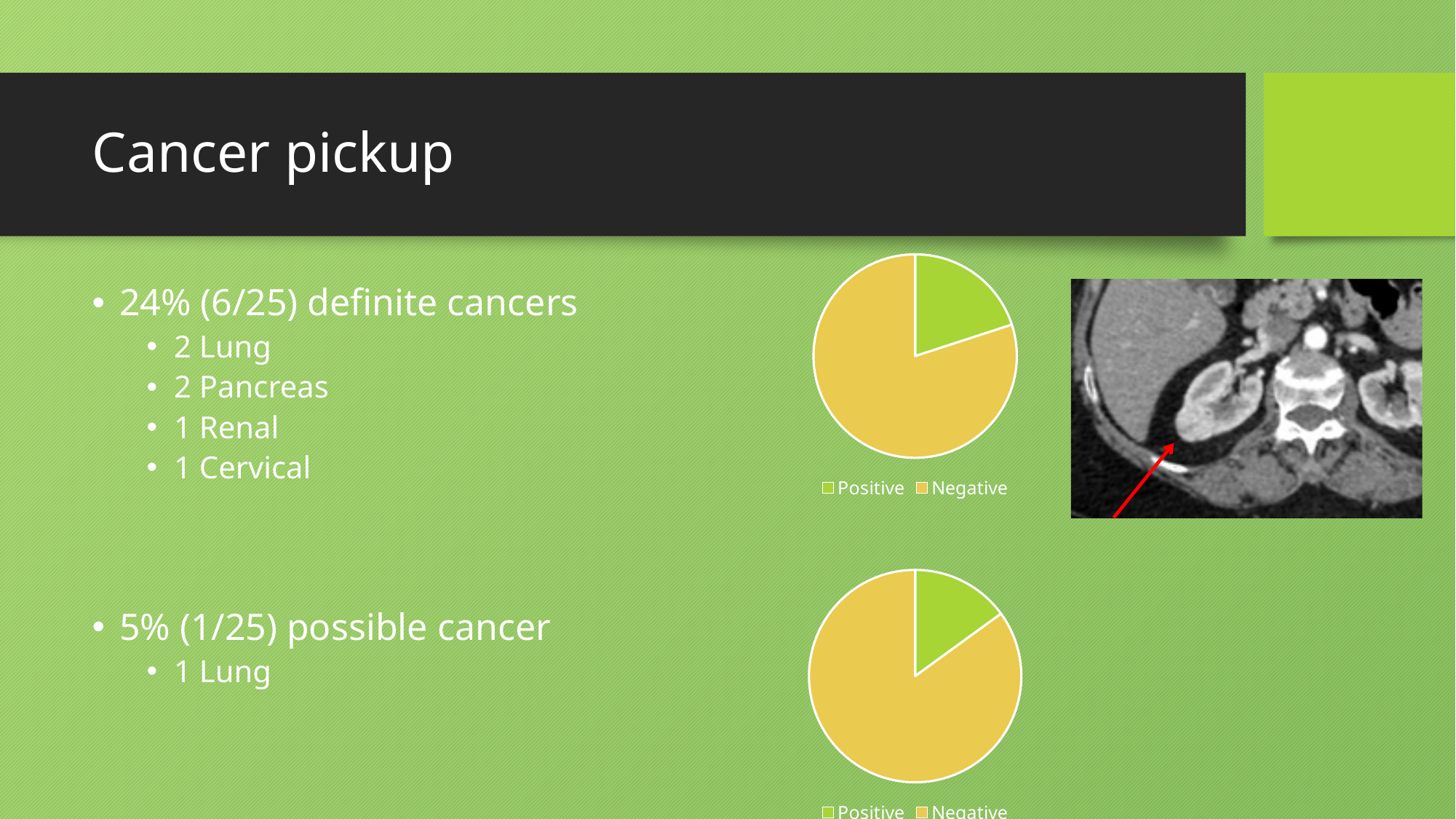
What are the two legend entries of the top pie chart? Positive and Negative In the top pie chart, what colour is the Positive slice? green How many entries does the legend of the bottom pie chart list? 2 In the bottom pie chart, which slice is larger, Positive or Negative? Negative In the top pie chart, which category has the smallest slice? Positive What kind of chart is the bottom chart on the slide? pie chart What kind of chart is the top chart on the slide? pie chart In the bottom pie chart, which category has the largest slice? Negative In the top pie chart, which slice is larger, Positive or Negative? Negative How many slices does the top pie chart have? 2